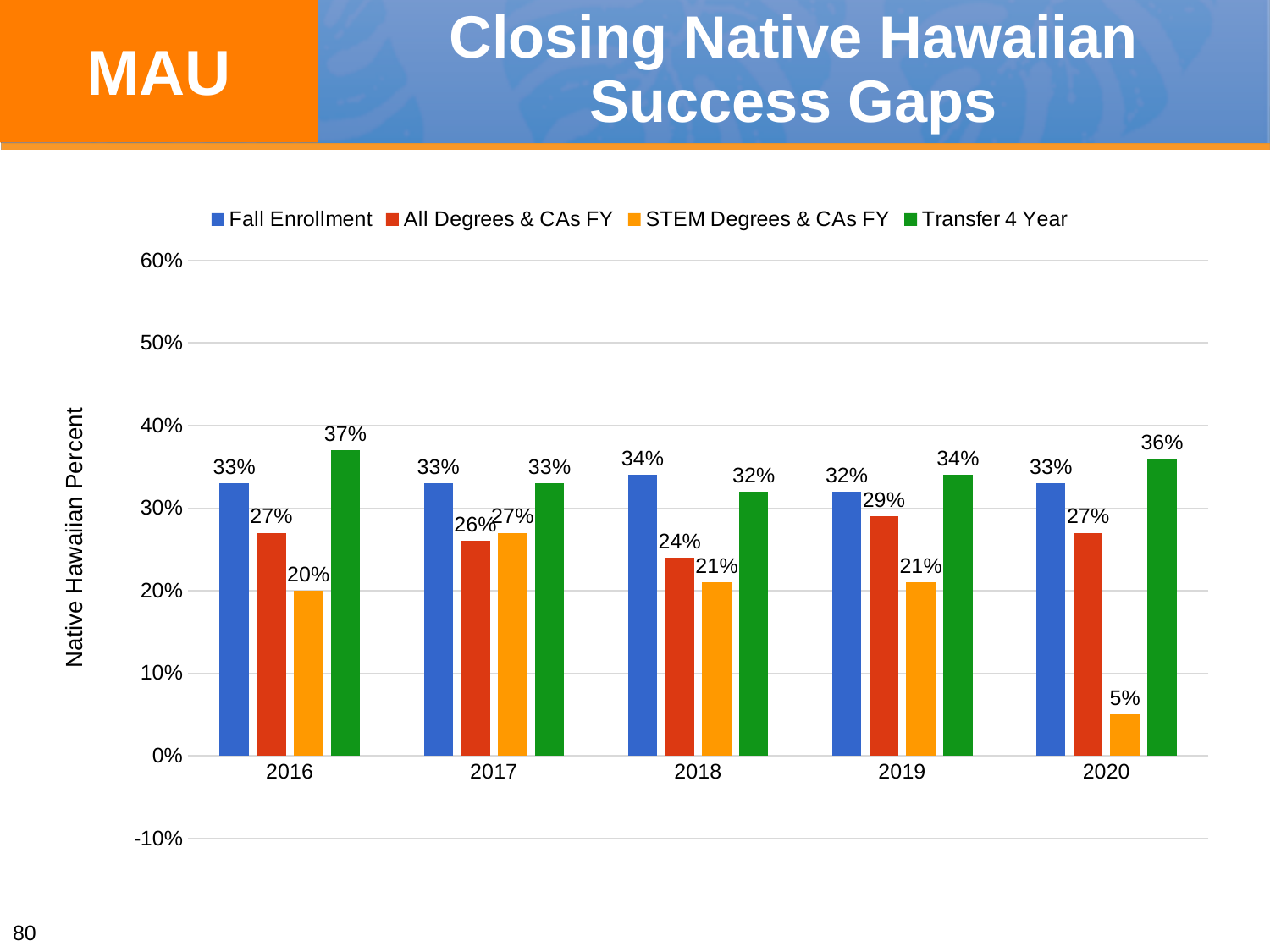
What is the label of the vertical axis? Native Hawaiian Percent What is the STEM Degrees & CAs FY value for 2020? 5% In which year is the STEM Degrees & CAs FY value lowest? 2020 What kind of chart is shown on the slide? Bar chart What is the Fall Enrollment value for 2018? 34% What is the Transfer 4 Year value for 2016? 37% How many years are shown on the x axis? 5 In which year is the Transfer 4 Year value highest? 2016 How many series does the legend list? 4 What is the difference between the Transfer 4 Year value and the STEM Degrees & CAs FY value in 2020? 31% What is the All Degrees & CAs FY value for 2019? 29% Which is larger in 2017: All Degrees & CAs FY or STEM Degrees & CAs FY? STEM Degrees & CAs FY